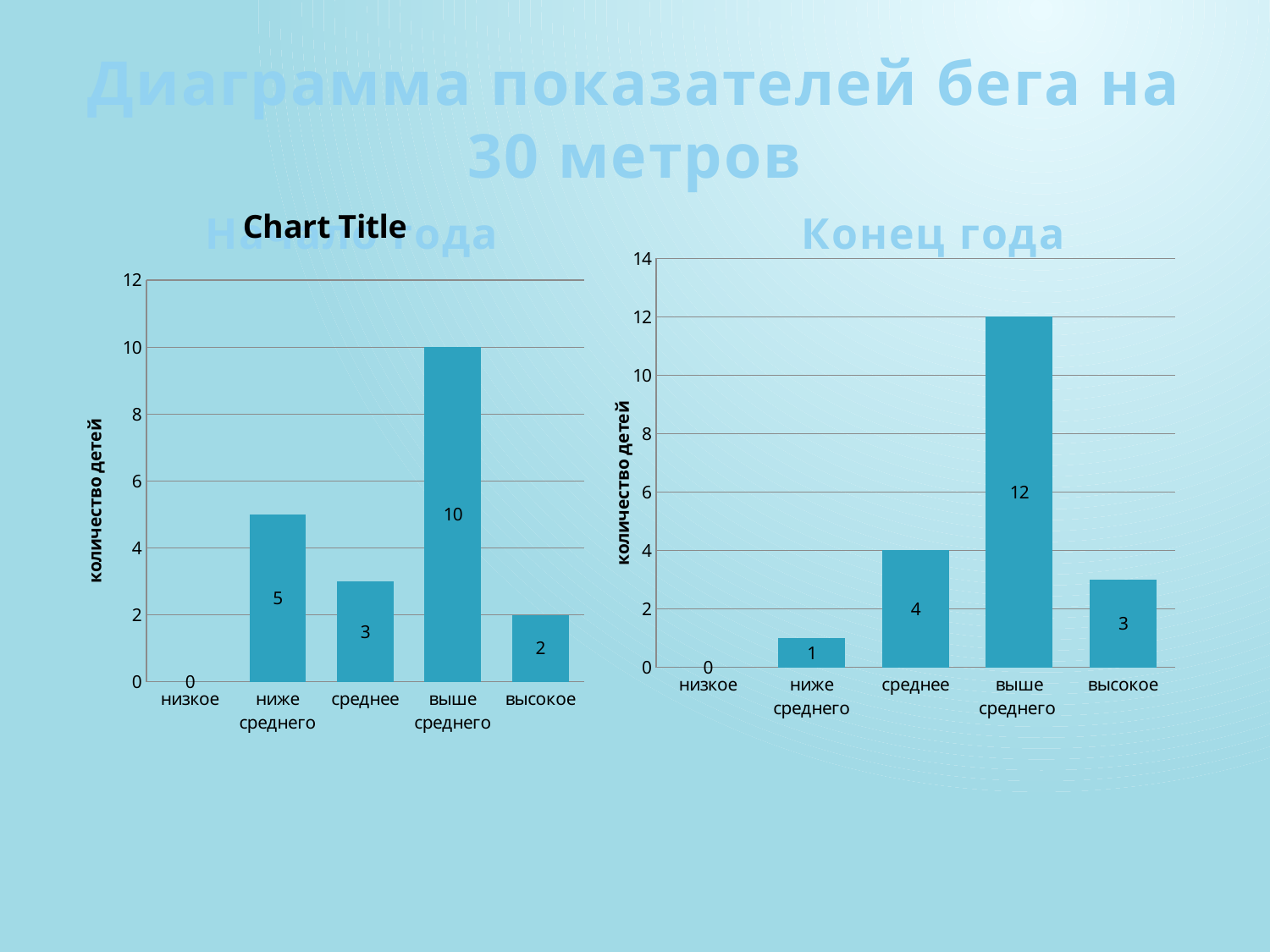
In the right chart (Конец года), which is larger: the value for "среднее" or the value for "высокое"? среднее In the right chart (Конец года), what is the value for "среднее"? 4 In the left chart, which category has the lowest value? низкое What is the y-axis label of the right chart (Конец года)? количество детей In the left chart, what is the value for "выше среднего"? 10 In the right chart (Конец года), which category has the highest value? выше среднего In the left chart, what is the difference between the values for "ниже среднего" and "среднее"? 2 What kind of chart is the left chart? bar chart How many categories are shown on the x axis of the right chart (Конец года)? 5 In the right chart (Конец года), what is the difference between the values for "выше среднего" and "высокое"? 9 In the left chart, what is the value for "ниже среднего"? 5 In the right chart (Конец года), what is the value for "ниже среднего"? 1